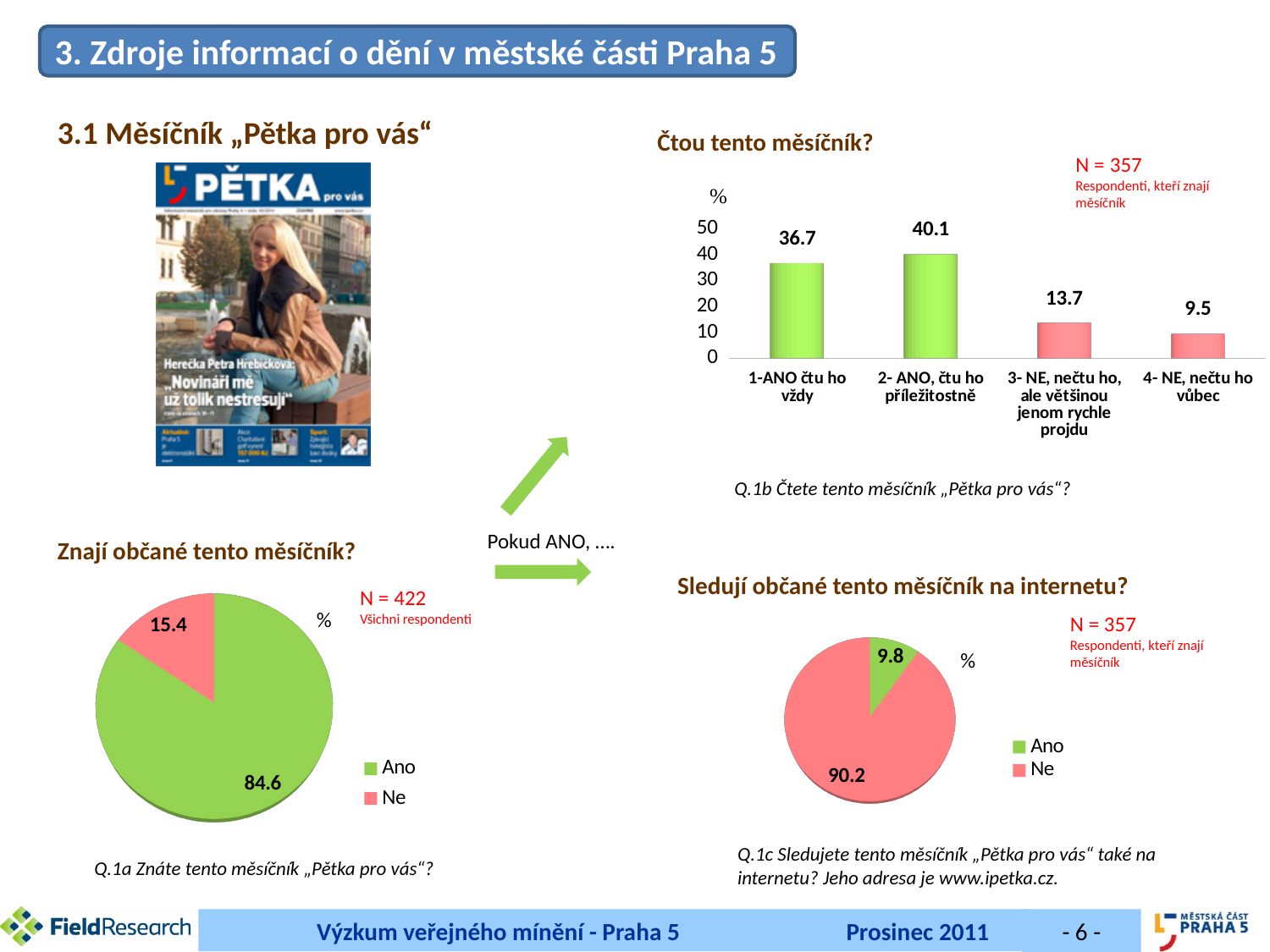
In the pie chart "Znají občané tento měsíčník?", what is the value for "Ano"? 84.6 In the bar chart "Čtou tento měsíčník?", what is the value for "2- ANO, čtu ho příležitostně"? 40.1 In the bar chart "Čtou tento měsíčník?", which category has the highest value? 2- ANO, čtu ho příležitostně In the bar chart "Čtou tento měsíčník?", what is the difference between "1-ANO čtu ho vždy" and "3- NE, nečtu ho, ale většinou jenom rychle projdu"? 23.0 What kind of chart is "Čtou tento měsíčník?"? bar chart In the pie chart "Znají občané tento měsíčník?", which slice is larger, "Ano" or "Ne"? Ano In the pie chart "Sledují občané tento měsíčník na internetu?", what is the difference between "Ne" and "Ano"? 80.4 What is the N (number of respondents) shown next to the pie chart "Znají občané tento měsíčník?"? N = 422 In the bar chart "Čtou tento měsíčník?", how many categories are shown? 4 How many entries does the legend of the pie chart "Sledují občané tento měsíčník na internetu?" list? 2 In the bar chart "Čtou tento měsíčník?", which category has the lowest value? 4- NE, nečtu ho vůbec In the pie chart "Sledují občané tento měsíčník na internetu?", what is the value for "Ne"? 90.2